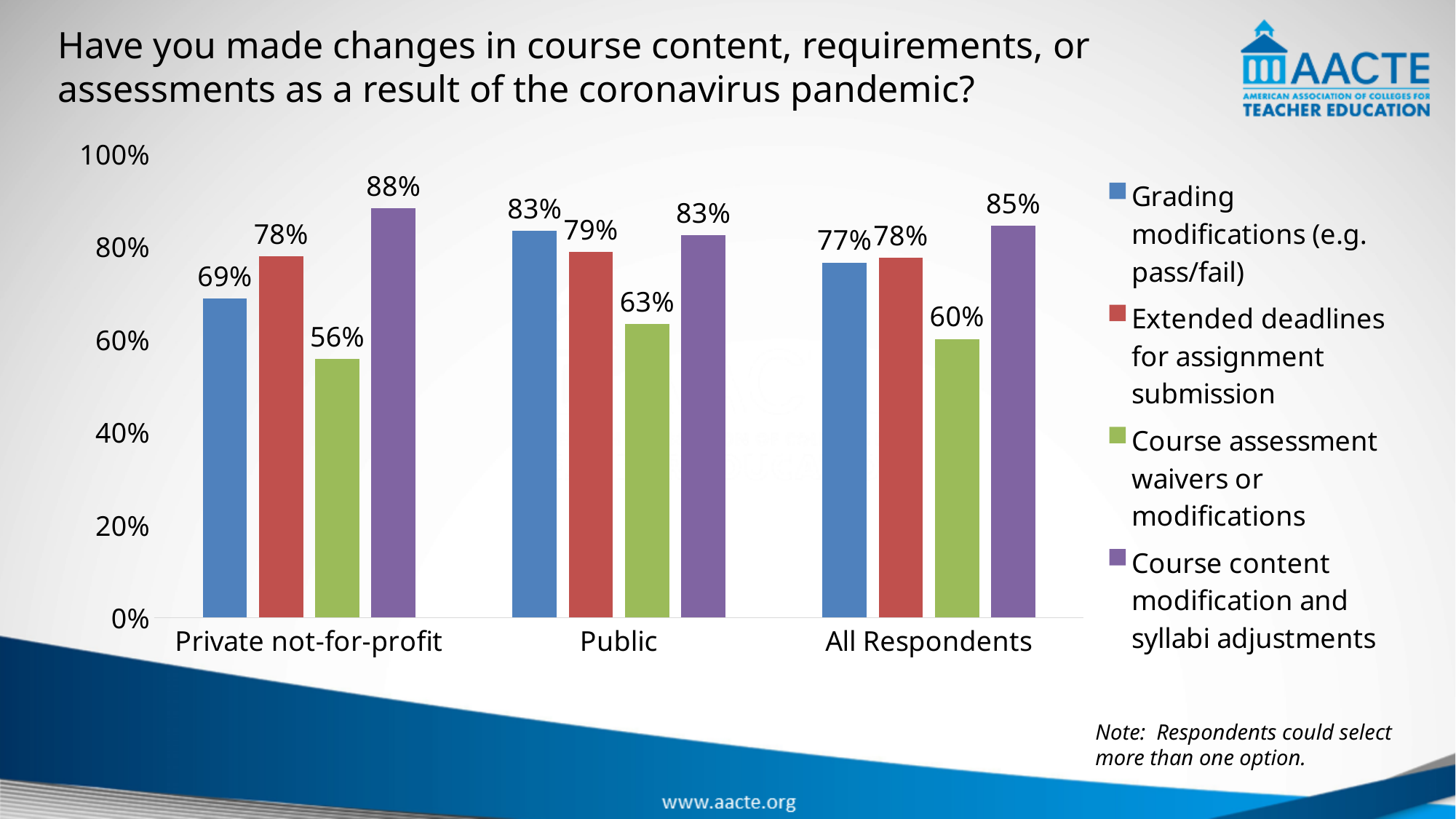
Which is larger: Grading modifications (e.g. pass/fail) for Private not-for-profit or for Public? Public Which category has the lowest value for Course assessment waivers or modifications? Private not-for-profit How many series does the legend list? 4 What percentage of Private not-for-profit respondents reported Course content modification and syllabi adjustments? 88% What is the difference between the Course content modification and syllabi adjustments values for Private not-for-profit and Public? 5% How many categories are shown on the x axis? 3 What is the value for Grading modifications (e.g. pass/fail) among Public respondents? 83% What percentage of All Respondents reported Course assessment waivers or modifications? 60% Which colour represents Extended deadlines for assignment submission in the legend? Red Which series has the highest value for All Respondents? Course content modification and syllabi adjustments What is the difference between Extended deadlines for assignment submission and Course assessment waivers or modifications for Public respondents? 16% What kind of chart is shown on the slide? Bar chart